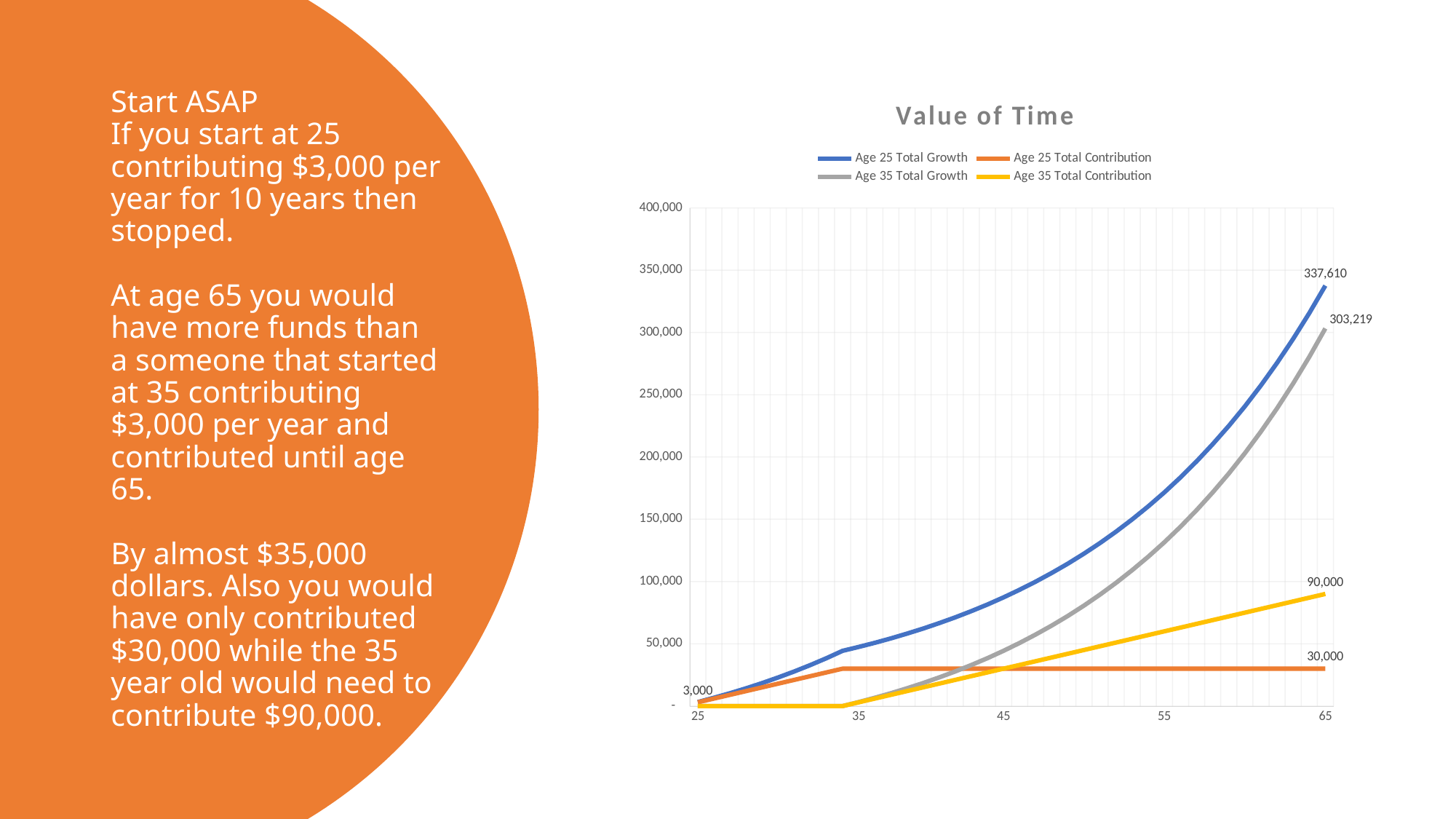
Which series has the highest value at age 65? Age 25 Total Growth Is the value for Age 25 Total Growth at age 45 greater or less than 100,000? less What is the value of Age 35 Total Growth at age 65? 303,219 What is the title of the chart? Value of Time Does the Age 35 Total Growth line rise or fall from age 35 to age 65? rise What is the value of Age 25 Total Growth at age 65? 337,610 How many series does the legend of the chart list? 4 What is the difference between Age 35 Total Contribution and Age 25 Total Contribution at age 65? 60,000 What is the difference between Age 25 Total Growth and Age 35 Total Growth at age 65? 34,391 What is the value of Age 35 Total Contribution at age 65? 90,000 What kind of chart is shown on the slide? line chart What is the value of Age 25 Total Contribution at age 65? 30,000